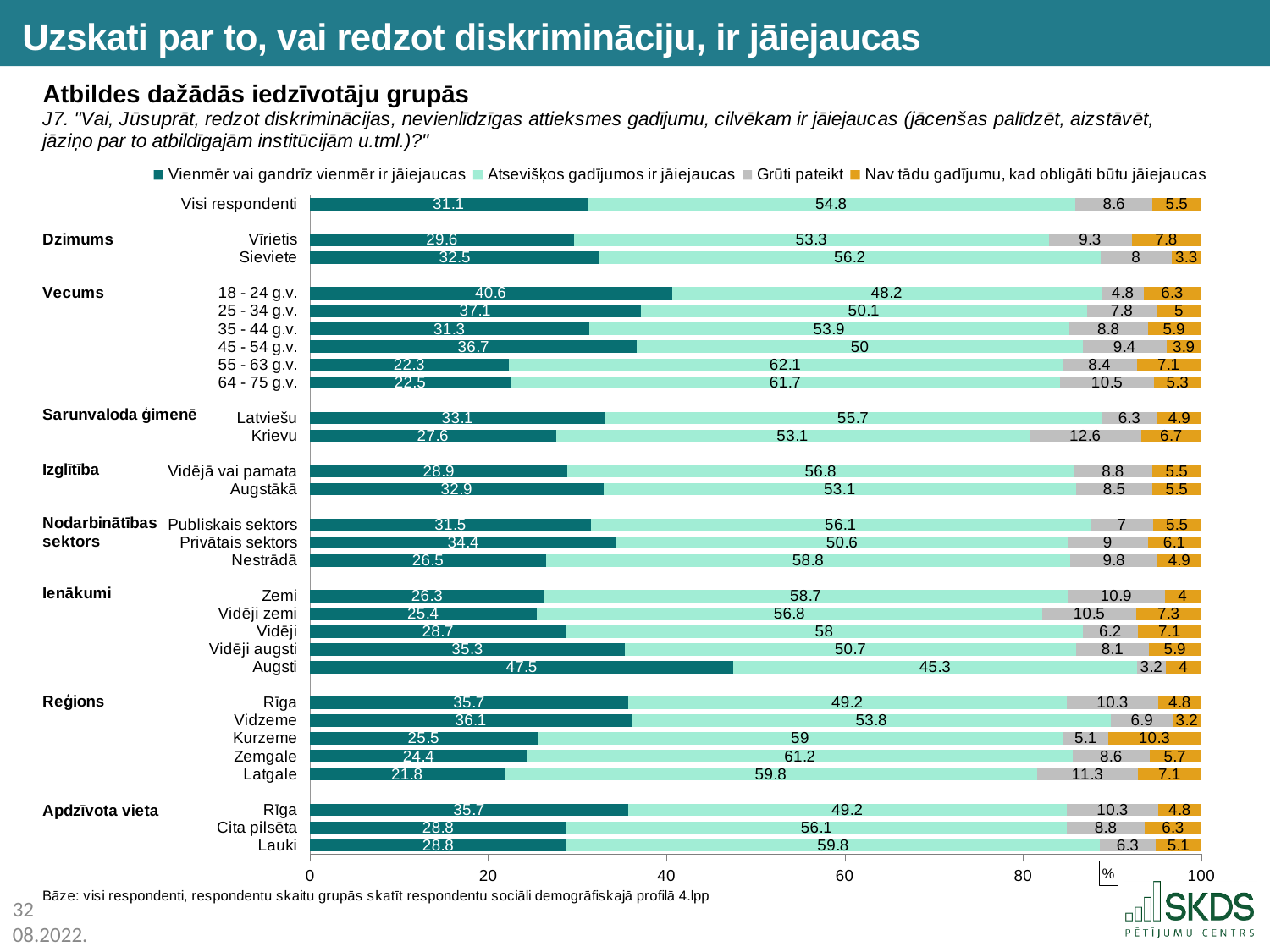
Which group has the highest "Vienmēr vai gandrīz vienmēr ir jāiejaucas" value? Augsti Which group has the highest "Atsevišķos gadījumos ir jāiejaucas" value? 55 - 63 g.v. Which has a larger "Vienmēr vai gandrīz vienmēr ir jāiejaucas" value, 18 - 24 g.v. or 25 - 34 g.v.? 18 - 24 g.v. What is the total of the stacked bar for Visi respondenti? 100 What is the "Nav tādu gadījumu, kad obligāti būtu jāiejaucas" value for Kurzeme? 10.3 Which group has the lowest "Vienmēr vai gandrīz vienmēr ir jāiejaucas" value? Latgale What is the value of "Vienmēr vai gandrīz vienmēr ir jāiejaucas" for Visi respondenti? 31.1 What is the difference between the "Vienmēr vai gandrīz vienmēr ir jāiejaucas" values for Sieviete and Vīrietis? 2.9 What is the "Grūti pateikt" value for the Krievu group? 12.6 What is the "Atsevišķos gadījumos ir jāiejaucas" value for Lauki? 59.8 What kind of chart is shown on the slide? Stacked bar chart How many series does the legend list? 4